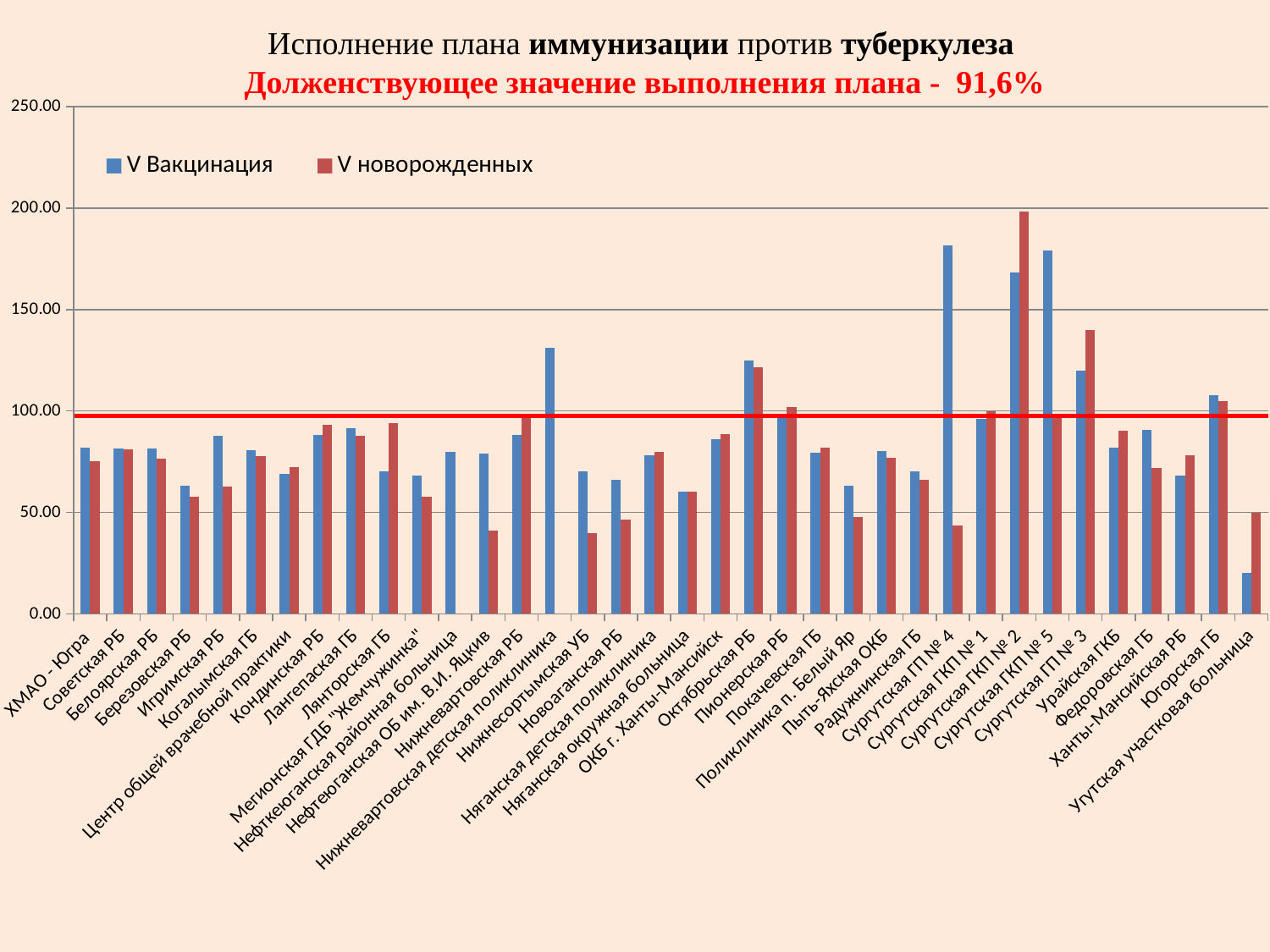
Which category has the lowest value for V Вакцинация? Угутская участковая больница Is the V новорожденных value for Сургутская ГКП № 2 greater or less than 150? greater For Сургутская ГП № 4, which series has the larger value, V Вакцинация or V новорожденных? V Вакцинация Is the V Вакцинация value for Нижневартовская детская поликлиника greater or less than 100? greater Is the V Вакцинация value for Угутская участковая больница greater or less than 50? less What kind of chart is shown on the slide? bar chart Which category has the highest value for V новорожденных? Сургутская ГКП № 2 How many series does the legend list? 2 What are the two series named in the legend? V Вакцинация and V новорожденных For Сургутская ГП № 3, which series has the larger value, V Вакцинация or V новорожденных? V новорожденных How many categories (institutions) are shown on the x axis? 36